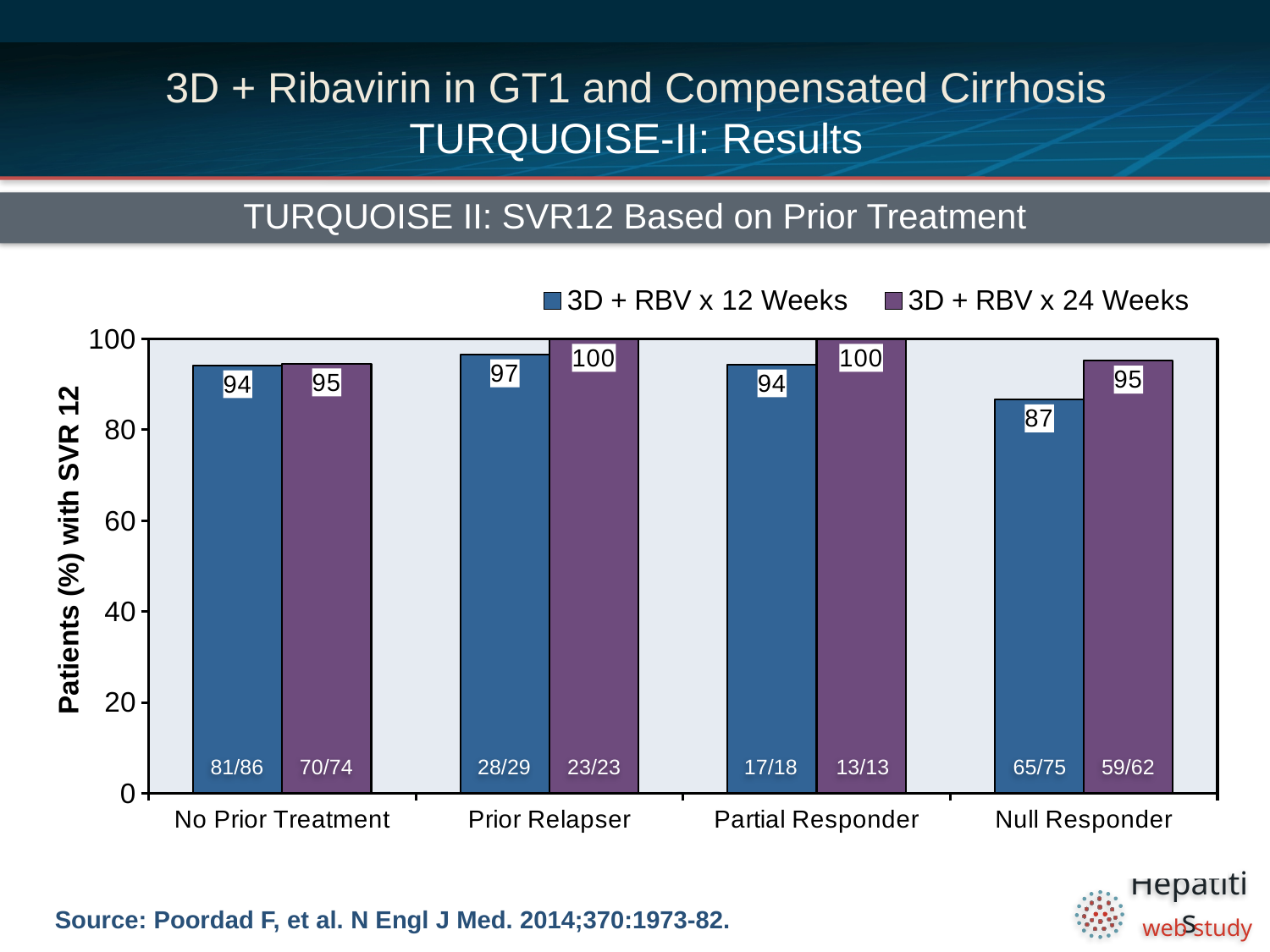
For Prior Relapser patients, which regimen has the higher SVR12 rate, 3D + RBV x 12 Weeks or 3D + RBV x 24 Weeks? 3D + RBV x 24 Weeks What is the patient fraction shown for Null Responder patients treated with 3D + RBV x 12 Weeks? 65/75 What is the SVR12 rate for Null Responder patients treated with 3D + RBV x 12 Weeks? 87 What is the difference between the 3D + RBV x 24 Weeks and 3D + RBV x 12 Weeks SVR12 rates for Partial Responder patients? 6 What is the label of the y axis? Patients (%) with SVR 12 What is the SVR12 rate for Prior Relapser patients treated with 3D + RBV x 24 Weeks? 100 What is the difference between the 3D + RBV x 24 Weeks and 3D + RBV x 12 Weeks SVR12 rates for Null Responder patients? 8 Which prior treatment category has the lowest SVR12 rate for 3D + RBV x 12 Weeks? Null Responder What is the SVR12 rate for No Prior Treatment patients treated with 3D + RBV x 12 Weeks? 94 How many prior treatment categories are shown on the x axis? 4 How many series does the legend list? 2 What kind of chart is shown on the slide? Bar chart